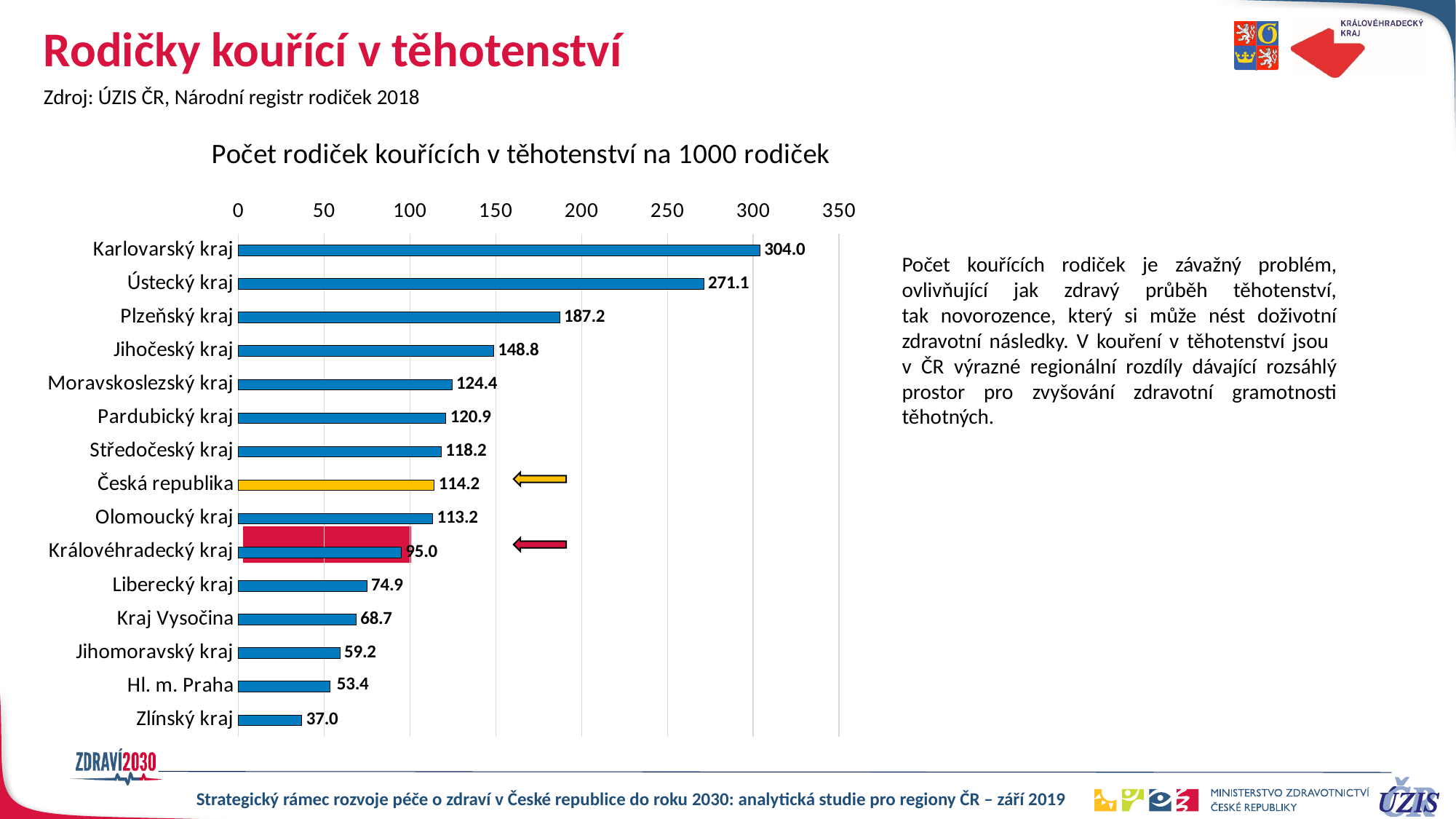
What kind of chart is shown on the slide? bar chart What is the difference between the values for Karlovarský kraj and Ústecký kraj? 32.9 How many categories are shown in the chart? 15 What is the value for Královéhradecký kraj? 95.0 Which has a larger value, Plzeňský kraj or Jihočeský kraj? Plzeňský kraj What is the difference between the values for Česká republika and Královéhradecký kraj? 19.2 What is the value for Česká republika? 114.2 Which region has the highest value? Karlovarský kraj Is the value for Liberecký kraj greater or less than 100? less What is the value for Karlovarský kraj? 304.0 Which region has the lowest value? Zlínský kraj What is the title of the chart? Počet rodiček kouřících v těhotenství na 1000 rodiček